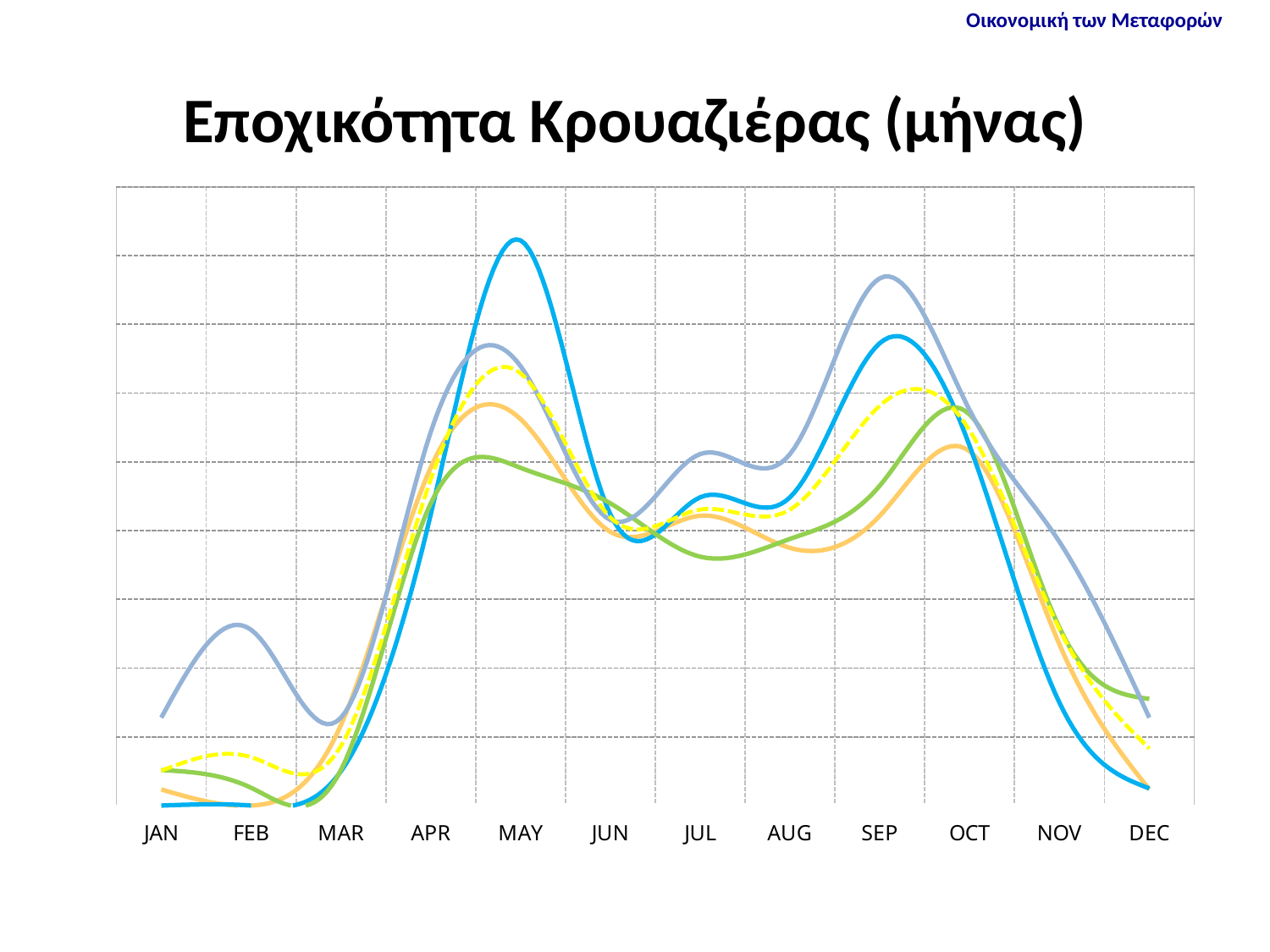
How many lines are plotted on the chart? 5 Does the bright blue line rise or fall from MAR to MAY? Rise Which line is the highest at FEB? The light grey-blue line Which line is the highest at SEP? The light grey-blue line What is the title of the chart on the slide? Εποχικότητα Κρουαζιέρας (μήνας) How many months are shown on the x axis of the chart? 12 In which month does the light grey-blue line reach its highest point? SEP What kind of chart is shown on the slide? Line chart At MAY, is the bright blue line higher or lower than the green line? Higher In which month does the bright blue line reach its highest point? MAY Does the bright blue line rise or fall from OCT to DEC? Fall